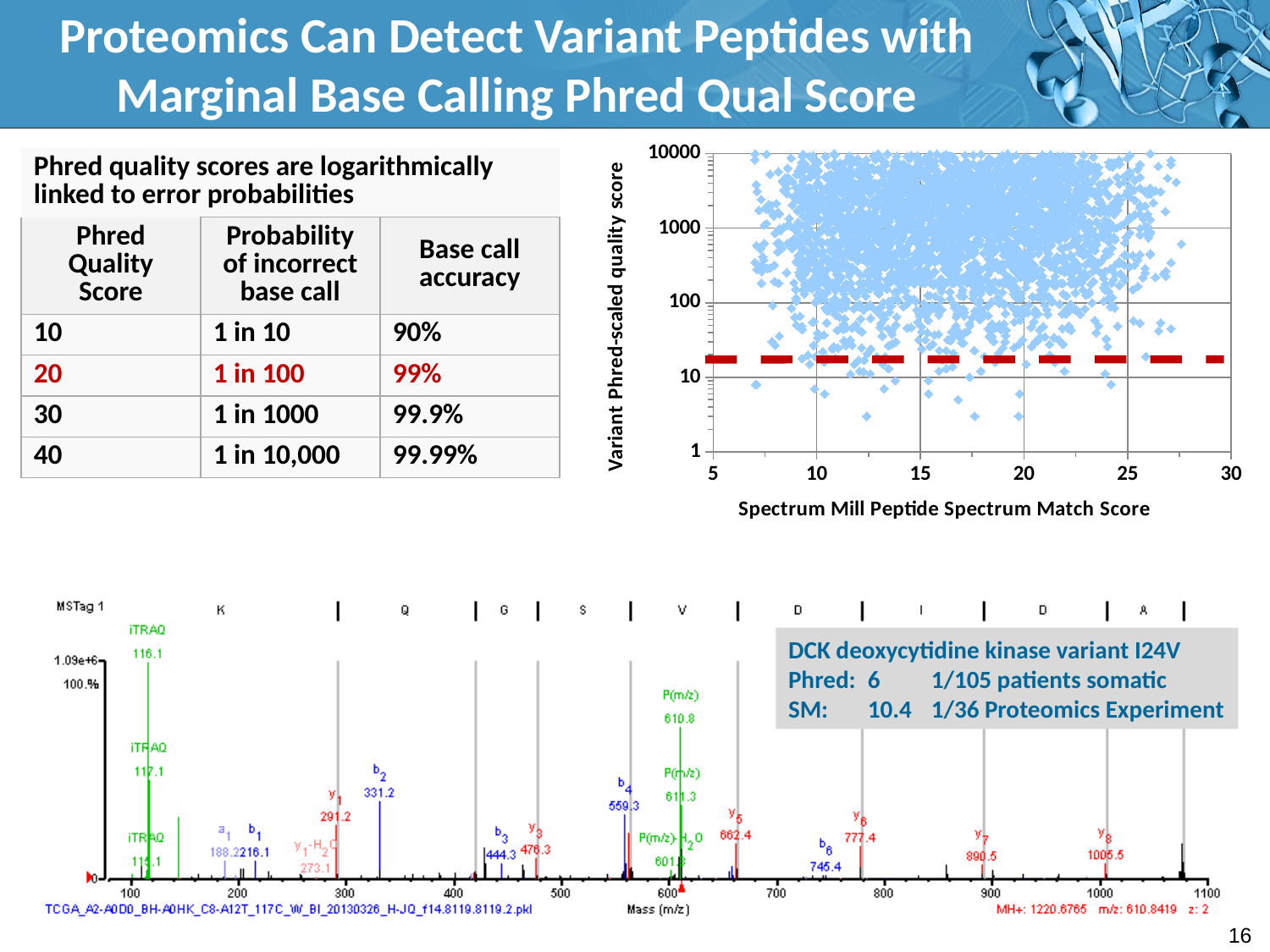
In the bottom mass spectrum chart, which labelled peak is the tallest? iTRAQ 116.1 In the bottom mass spectrum chart, what is the difference between the m/z values labelled for y8 and y7? 115.0 In the bottom mass spectrum chart, what is the m/z value labelled for the b6 ion? 745.4 What kind of chart is the top-right chart with the axis 'Spectrum Mill Peptide Spectrum Match Score'? Scatter plot In the top-right scatter plot, what is the title of the y axis? Variant Phred-scaled quality score In the bottom mass spectrum chart, what is the m/z value labelled for the y8 ion? 1005.5 In the bottom mass spectrum chart, which peak is taller, b2 (331.2) or b4 (559.3)? b2 (331.2) In the bottom mass spectrum chart, what is the m/z value labelled for the b2 ion? 331.2 In the bottom mass spectrum chart, what is the label of the x axis? Mass (m/z) In the bottom mass spectrum chart, which peak is taller, y5 (662.4) or y7 (890.5)? y5 (662.4) In the top-right scatter plot, what is the highest value shown on the x axis? 30 In the top-right scatter plot, what is the highest tick value shown on the y axis? 10000